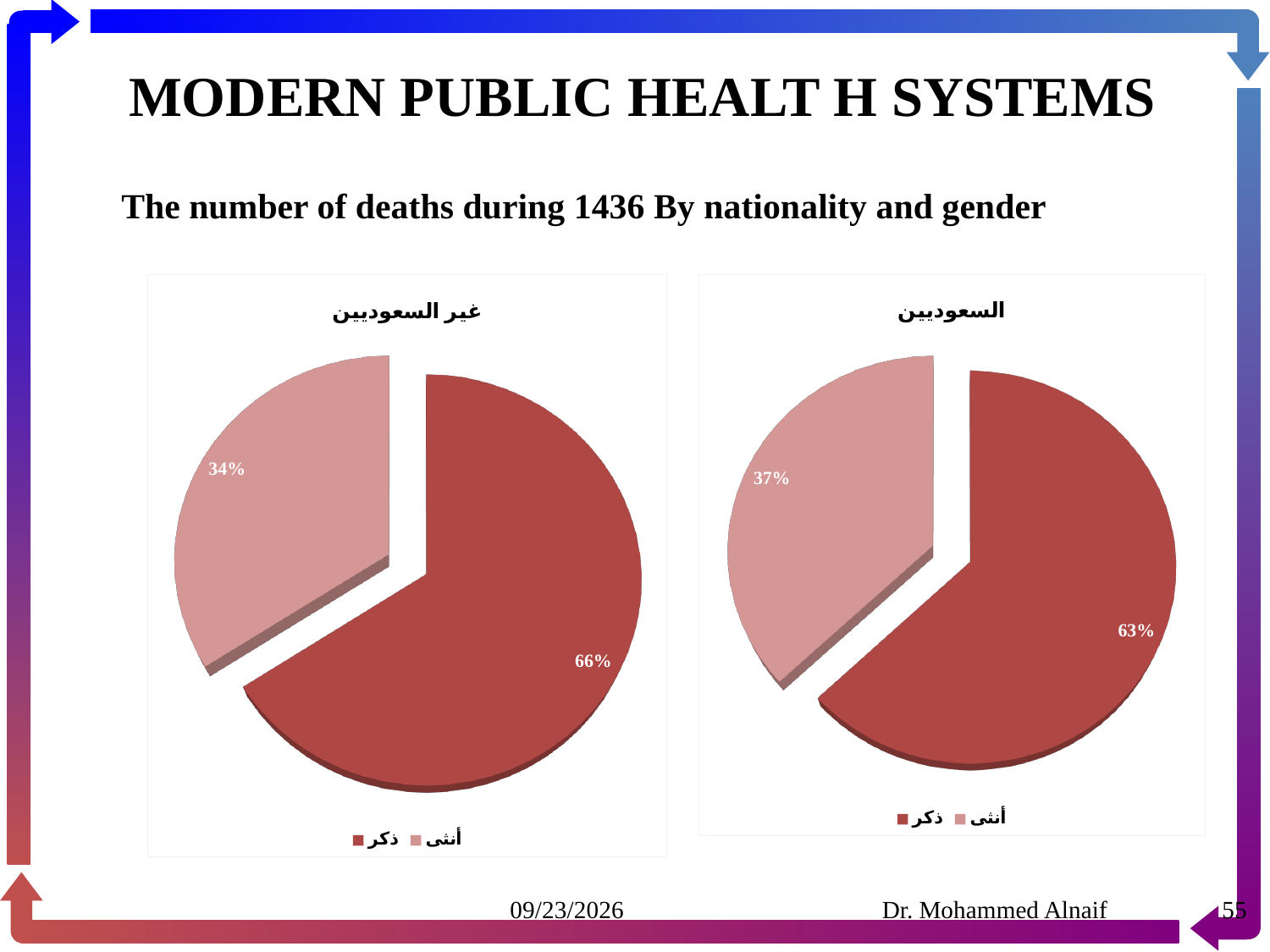
In the left chart (غير السعوديين), what share of the pie is labelled for the "ذكر" slice? 66% What kind of chart is the left chart titled "غير السعوديين"? pie chart In the left chart (غير السعوديين), what share of the pie is labelled for the "أنثى" slice? 34% In the left chart (غير السعوديين), what is the difference in percentage points between the "ذكر" and "أنثى" slices? 32 In the right chart (السعوديين), what share of the pie is labelled for the "ذكر" slice? 63% How many entries does the legend of the left chart (غير السعوديين) list? 2 In the left chart (غير السعوديين), which slice is the smallest? أنثى In the right chart (السعوديين), what is the difference in percentage points between the "ذكر" and "أنثى" slices? 26 Which chart has the larger "أنثى" share, the left chart (غير السعوديين) or the right chart (السعوديين)? the right chart (السعوديين) How many slices does the right chart (السعوديين) have? 2 In the right chart (السعوديين), which slice is the largest? ذكر